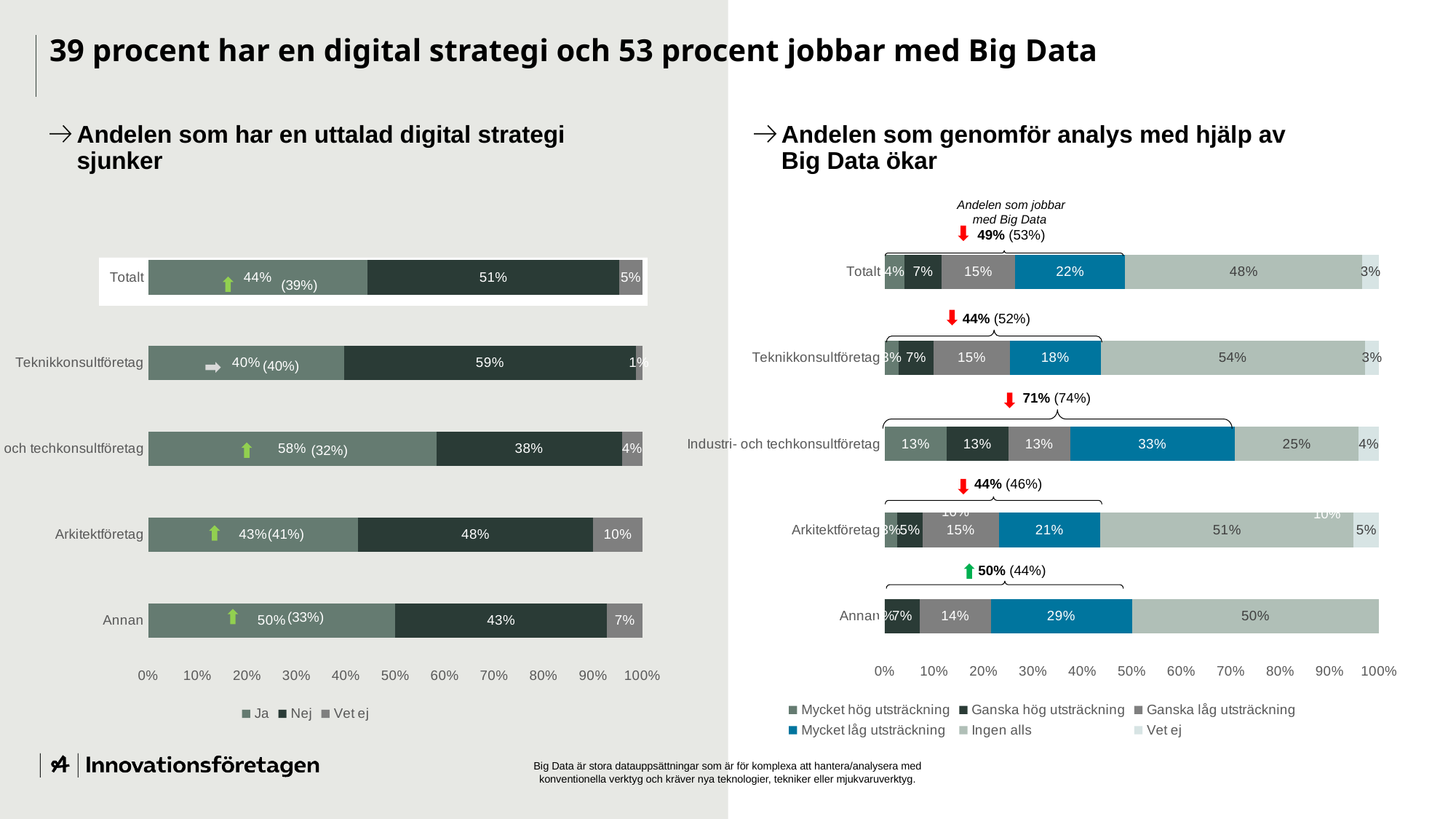
In the right chart (Andelen som genomför analys med hjälp av Big Data ökar), what is the 'Ingen alls' value for Teknikkonsultföretag? 54% In the left chart (Andelen som har en uttalad digital strategi sjunker), which category has the highest 'Nej' value? Teknikkonsultföretag In the left chart (Andelen som har en uttalad digital strategi sjunker), which category has the lowest 'Vet ej' value? Teknikkonsultföretag In the right chart (Andelen som genomför analys med hjälp av Big Data ökar), is the 'Mycket låg utsträckning' value larger for Annan or for Arkitektföretag? Annan In the left chart (Andelen som har en uttalad digital strategi sjunker), what is the difference between the 'Nej' values for Teknikkonsultföretag and Annan? 16% In the left chart (Andelen som har en uttalad digital strategi sjunker), what is the 'Ja' value for Teknikkonsultföretag? 40% In the right chart (Andelen som genomför analys med hjälp av Big Data ökar), which category has the lowest 'Ingen alls' value? Industri- och techkonsultföretag In the left chart (Andelen som har en uttalad digital strategi sjunker), how many series does the legend list? 3 In the left chart (Andelen som har en uttalad digital strategi sjunker), what is the 'Nej' value for Arkitektföretag? 48% In the left chart (Andelen som har en uttalad digital strategi sjunker), what kind of chart is shown? Stacked bar chart In the right chart (Andelen som genomför analys med hjälp av Big Data ökar), how many series does the legend list? 6 In the right chart (Andelen som genomför analys med hjälp av Big Data ökar), what is the 'Mycket låg utsträckning' value for Industri- och techkonsultföretag? 33%